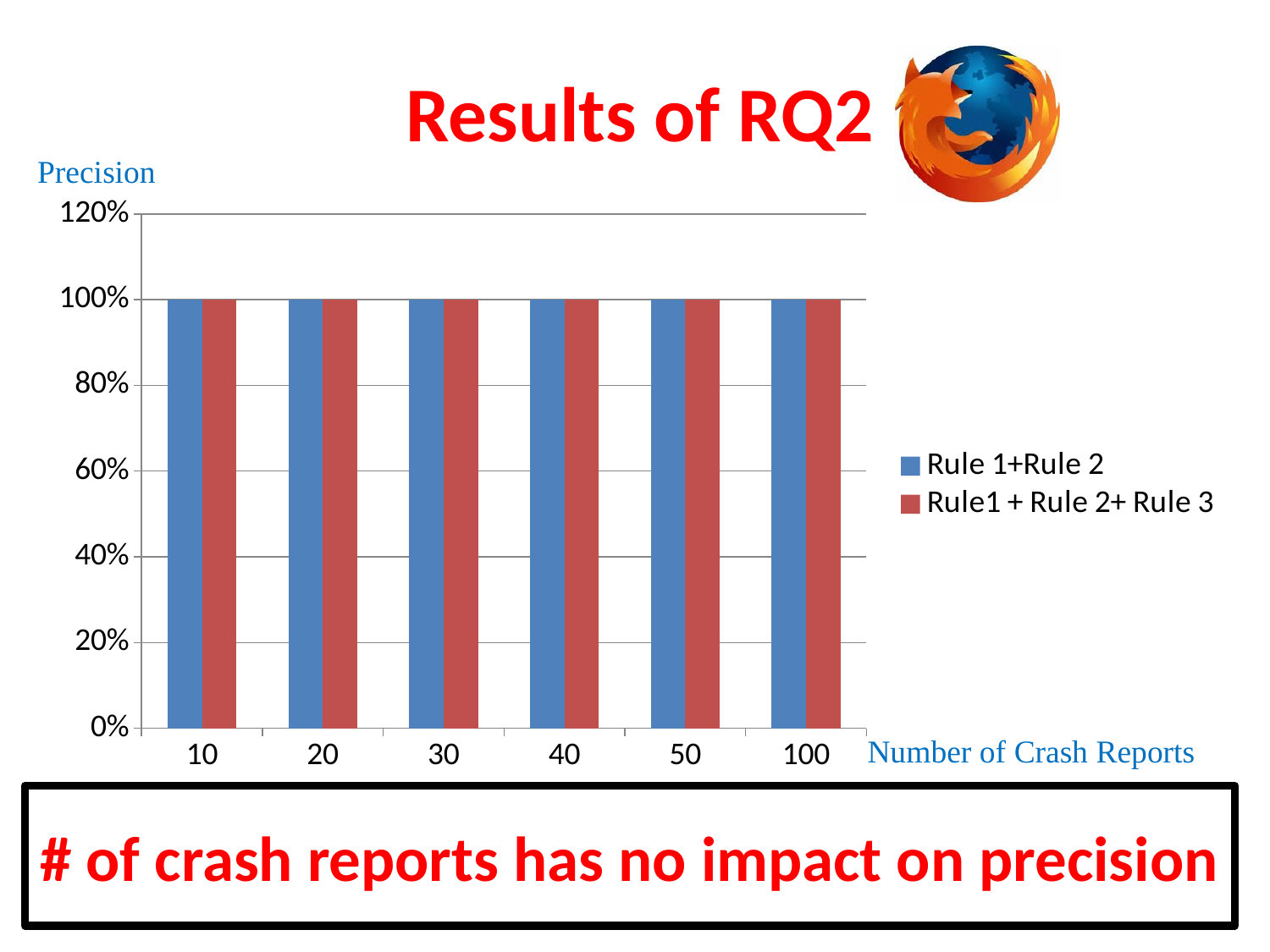
What is the difference between the precision of Rule 1+Rule 2 and Rule1 + Rule 2+ Rule 3 at 20 crash reports? 0% Do the values for Rule 1+Rule 2 rise, fall, or stay the same as the number of crash reports increases? stay the same What is the precision for Rule 1+Rule 2 at 50 crash reports? 100% Which colour represents Rule1 + Rule 2+ Rule 3 in the legend? red Is the value for Rule1 + Rule 2+ Rule 3 at 30 crash reports greater or less than 80%? greater What kind of chart is shown on the slide? bar chart What is the precision for Rule1 + Rule 2+ Rule 3 at 100 crash reports? 100% Is the value for Rule 1+Rule 2 at 40 crash reports greater or less than 120%? less How many categories are shown on the x axis? 6 What is the precision for Rule 1+Rule 2 at 10 crash reports? 100% How many series does the legend list? 2 What is the label of the x axis? Number of Crash Reports